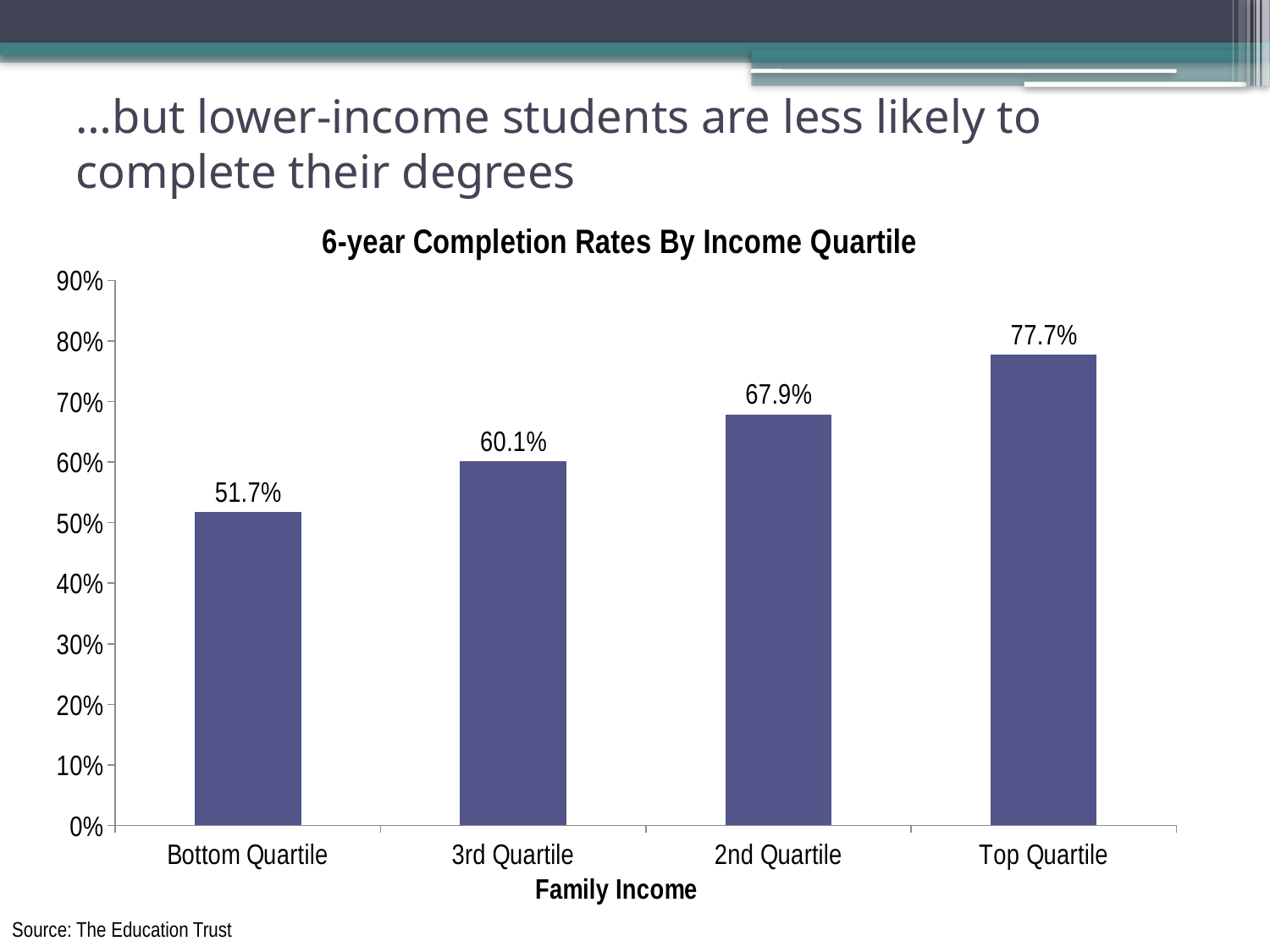
How many income quartiles are shown in the chart? 4 What is the 6-year completion rate for the Top Quartile? 77.7% Which income quartile has the highest 6-year completion rate? Top Quartile What is the 6-year completion rate for the 3rd Quartile? 60.1% Do completion rates rise or fall moving from the Bottom Quartile to the Top Quartile? Rise What type of chart is used to show the 6-year completion rates? Bar chart What is the difference in completion rate between the Top Quartile and the Bottom Quartile? 26 percentage points Which income quartile has the lowest 6-year completion rate? Bottom Quartile Which has a higher completion rate, the 2nd Quartile or the 3rd Quartile? 2nd Quartile What is the title of the chart? 6-year Completion Rates By Income Quartile What is the 6-year completion rate for the 2nd Quartile? 67.9% What is the 6-year completion rate for the Bottom Quartile? 51.7%